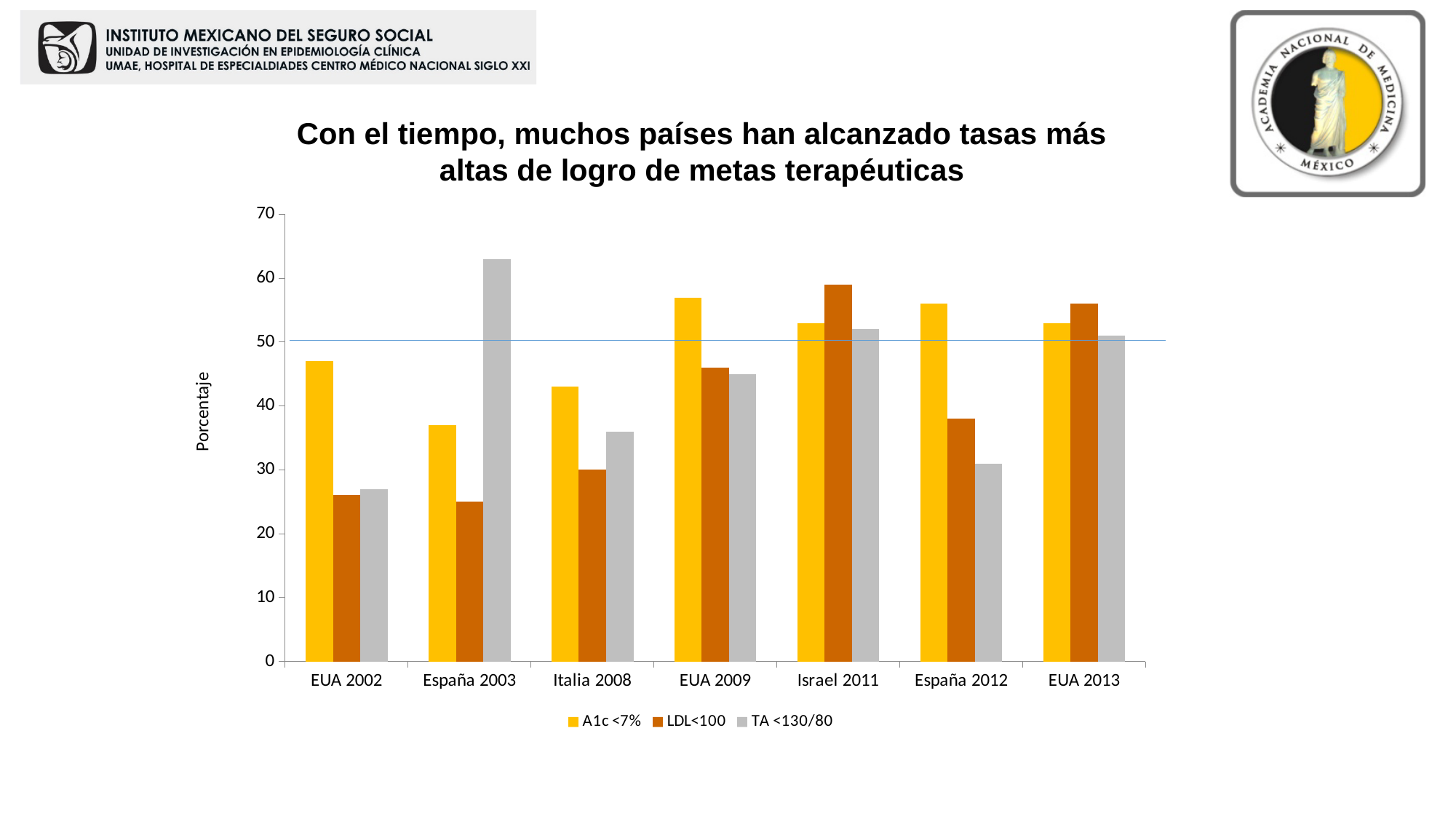
Is the value for TA <130/80 in EUA 2002 greater or less than 30? less Is the value for LDL<100 in Israel 2011 greater or less than 50? greater Is the value for TA <130/80 in España 2003 greater or less than 60? greater Which category has the lowest value for A1c <7%? España 2003 In EUA 2009, which is larger: A1c <7% or LDL<100? A1c <7% In Israel 2011, which is larger: LDL<100 or A1c <7%? LDL<100 How many country-year categories are shown on the x axis? 7 What is the label of the y axis? Porcentaje Which category has the highest value for TA <130/80? España 2003 How many series does the legend list? 3 What kind of chart is shown on the slide? bar chart